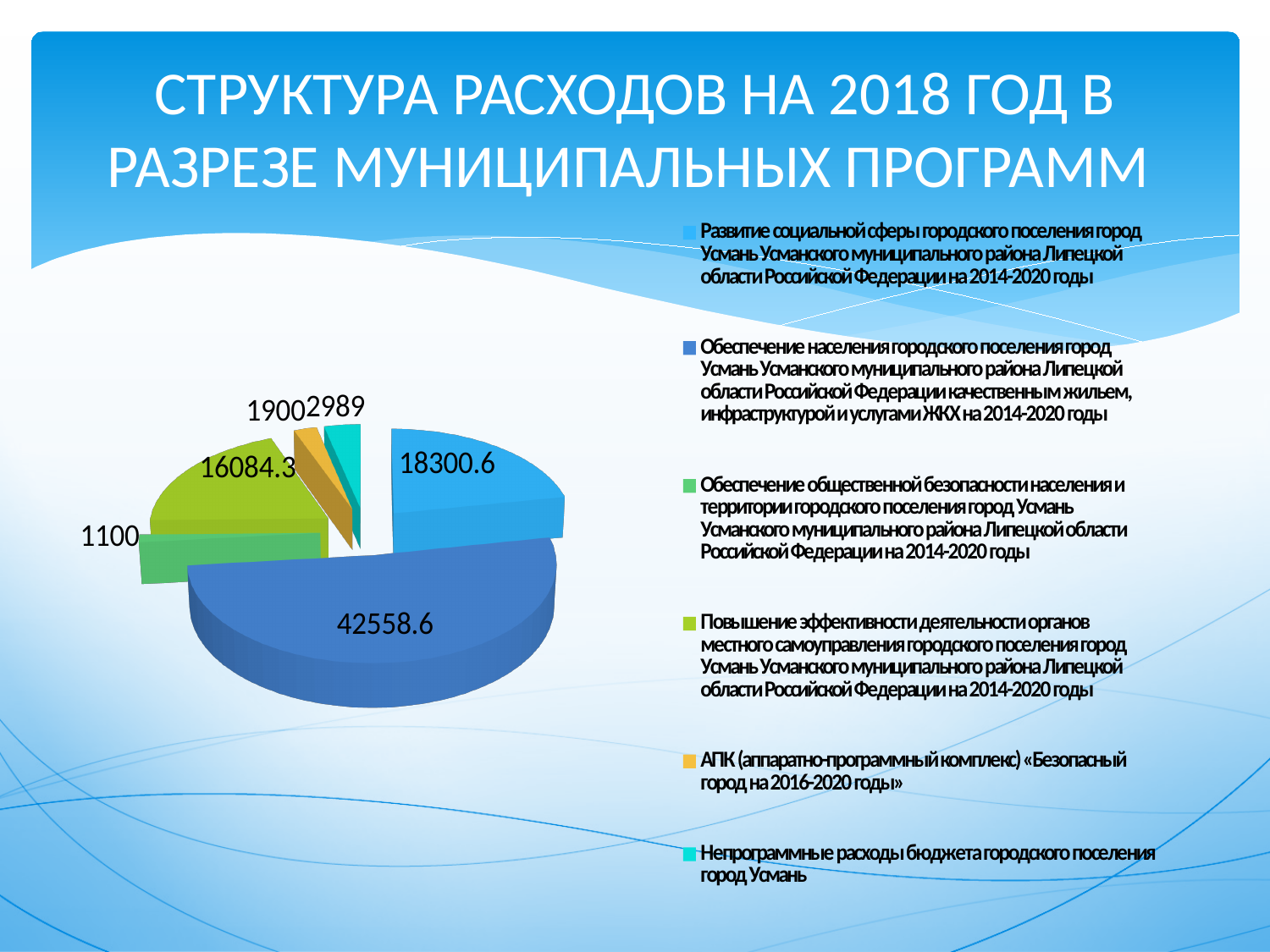
What type of chart is shown on the slide? Pie chart Which is larger: the slice valued 16084.3 or the slice valued 18300.6? 18300.6 What is the value of the smallest slice of the pie chart? 1100 What is the difference between the largest slice (42558.6) and the slice valued 18300.6? 24258 How many slices does the pie chart have? 6 What is the value of the slice for 'Повышение эффективности деятельности органов местного самоуправления...'? 16084.3 How many entries does the legend list? 6 What is the title of the slide containing the pie chart? СТРУКТУРА РАСХОДОВ НА 2018 ГОД В РАЗРЕЗЕ МУНИЦИПАЛЬНЫХ ПРОГРАММ What is the value shown for the slice labelled 'Непрограммные расходы бюджета городского поселения город Усмань'? 2989 What is the value shown for the slice labelled 'АПК (аппаратно-программный комплекс) «Безопасный город на 2016-2020 годы»'? 1900 What is the difference between the slices valued 2989 and 1900? 1089 What is the value of the largest slice of the pie chart? 42558.6